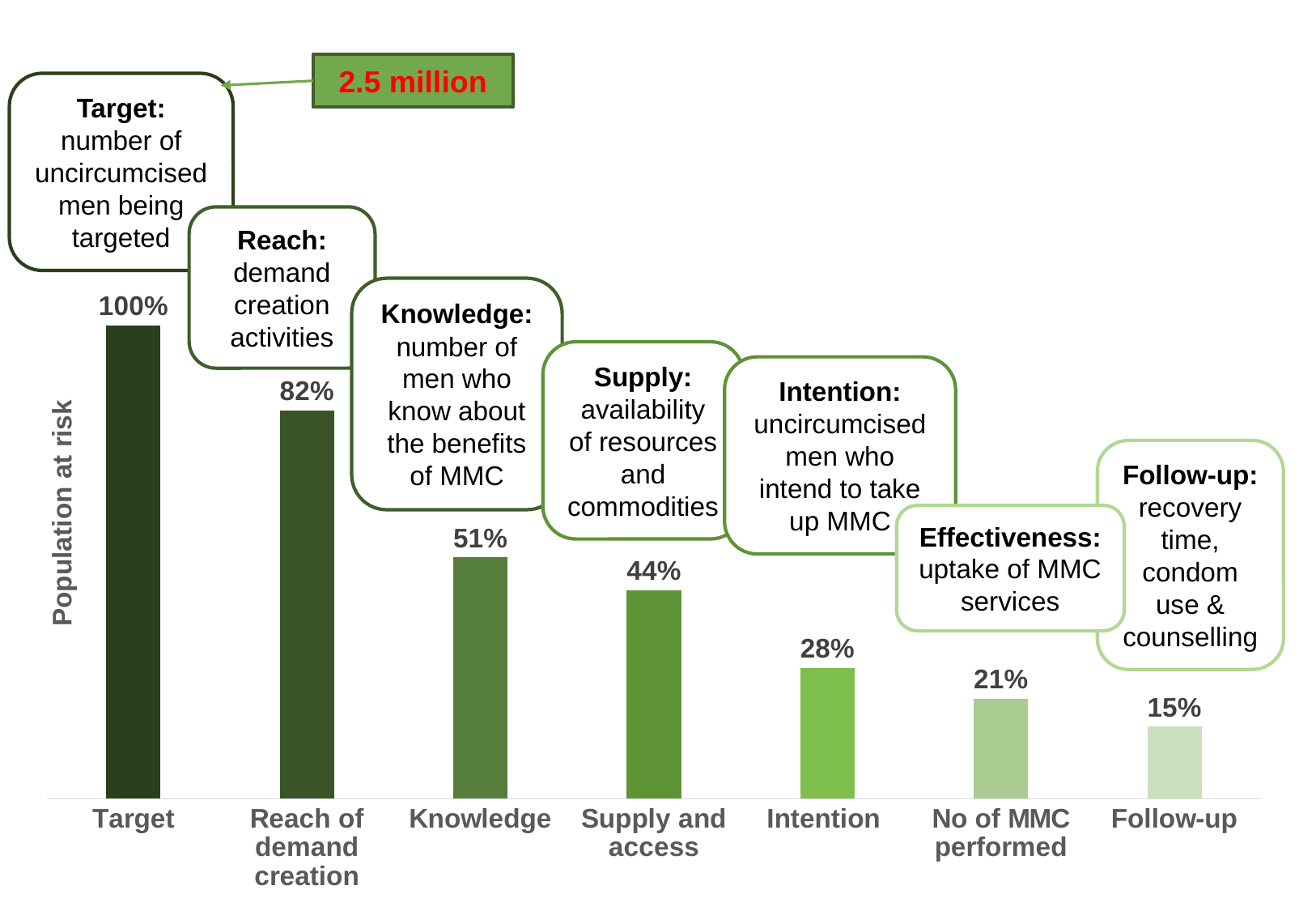
Do the values rise or fall from left to right along the x axis? fall What is the value for Reach of demand creation? 82% What is the value for Intention? 28% Which category has the highest value? Target What kind of chart is this? bar chart What is the difference between the values for Target and Follow-up? 85% What is the value for No of MMC performed? 21% What is the difference between the values for Supply and access and Intention? 16% What is the value for Knowledge? 51% How many categories are shown on the x axis? 7 Which is larger, the value for Knowledge or the value for Supply and access? Knowledge Which category has the lowest value? Follow-up